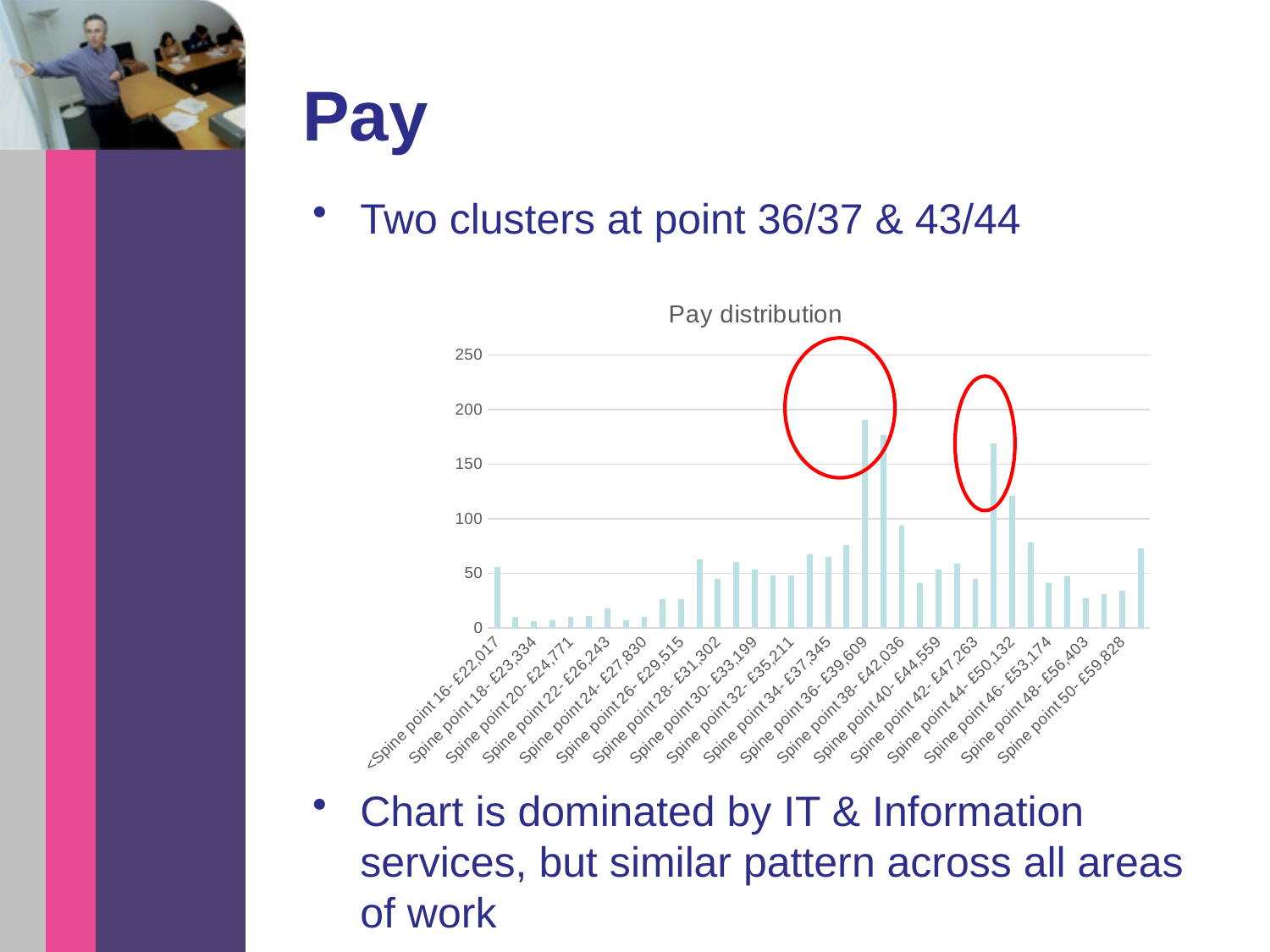
Which is larger, the value for Spine point 18- £23,334 or the value for Spine point 34- £37,345? Spine point 34- £37,345 Is the value for Spine point 18- £23,334 greater or less than 50? less Which category has the highest bar in the Pay distribution chart? Spine point 36- £39,609 Is the value for Spine point 46- £53,174 greater or less than 50? less Is the value for Spine point 50- £59,828 greater or less than 50? less What is the title of the chart? Pay distribution What kind of chart is shown on the slide? bar chart Which is larger, the value for Spine point 36- £39,609 or the value for Spine point 44- £50,132? Spine point 36- £39,609 What is the highest value shown on the vertical axis of the chart? 250 Do the values generally rise or fall from Spine point 16 to Spine point 36? rise